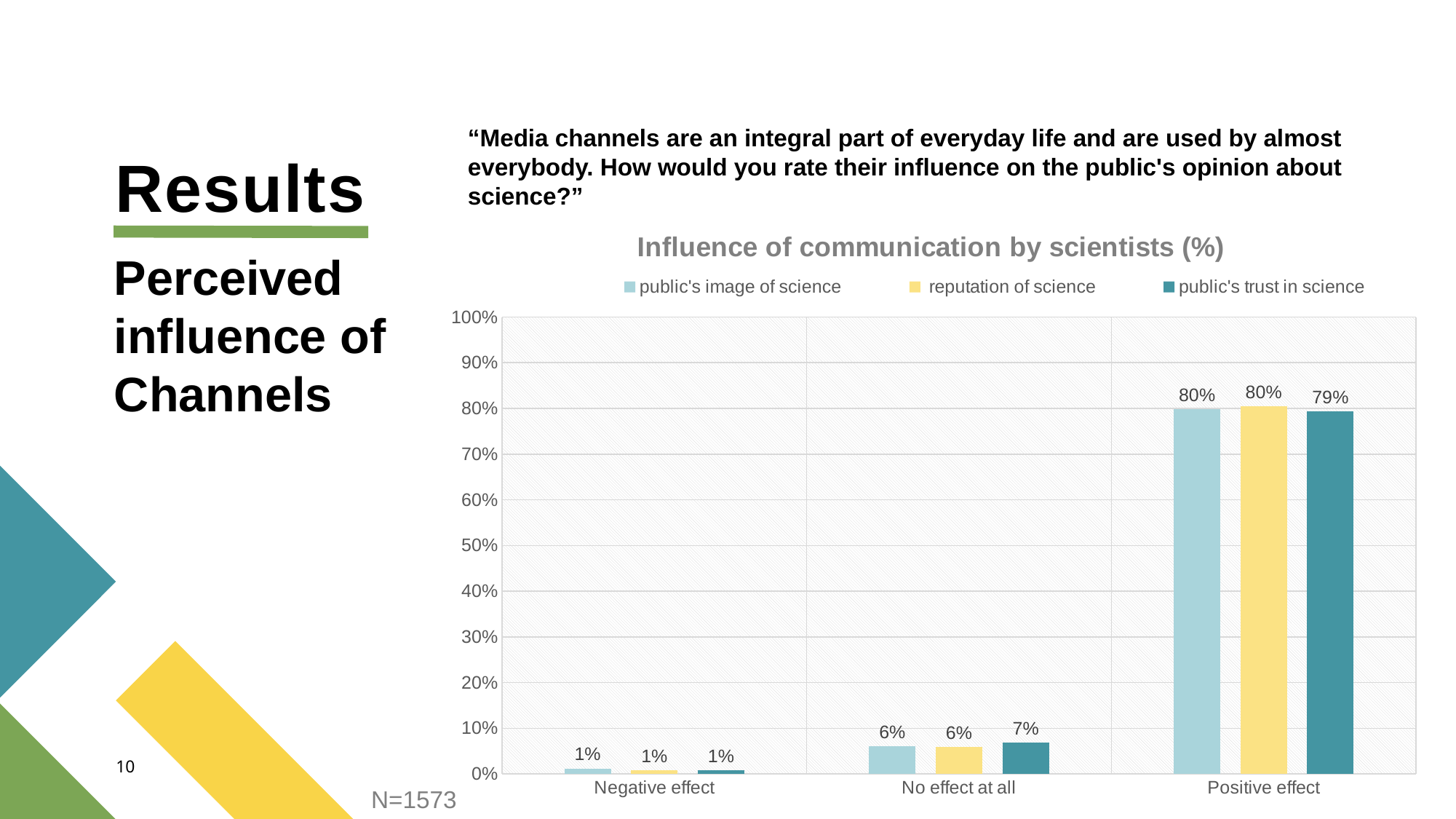
What is the value for "reputation of science" in the "Negative effect" category? 1% Which category has the highest value for "reputation of science"? Positive effect What is the title of the chart? Influence of communication by scientists (%) How many series does the legend list? 3 Which category has the lowest value for "public's image of science"? Negative effect What is the value for "public's image of science" in the "Positive effect" category? 80% What kind of chart is shown on the slide? Bar chart Which is larger: the "public's trust in science" value for "No effect at all" or for "Negative effect"? No effect at all What is the difference between the "public's image of science" values for "Positive effect" and "No effect at all"? 74% What is the value for "public's trust in science" in the "No effect at all" category? 7% How many categories are shown on the x axis? 3 What is the value for "public's trust in science" in the "Positive effect" category? 79%